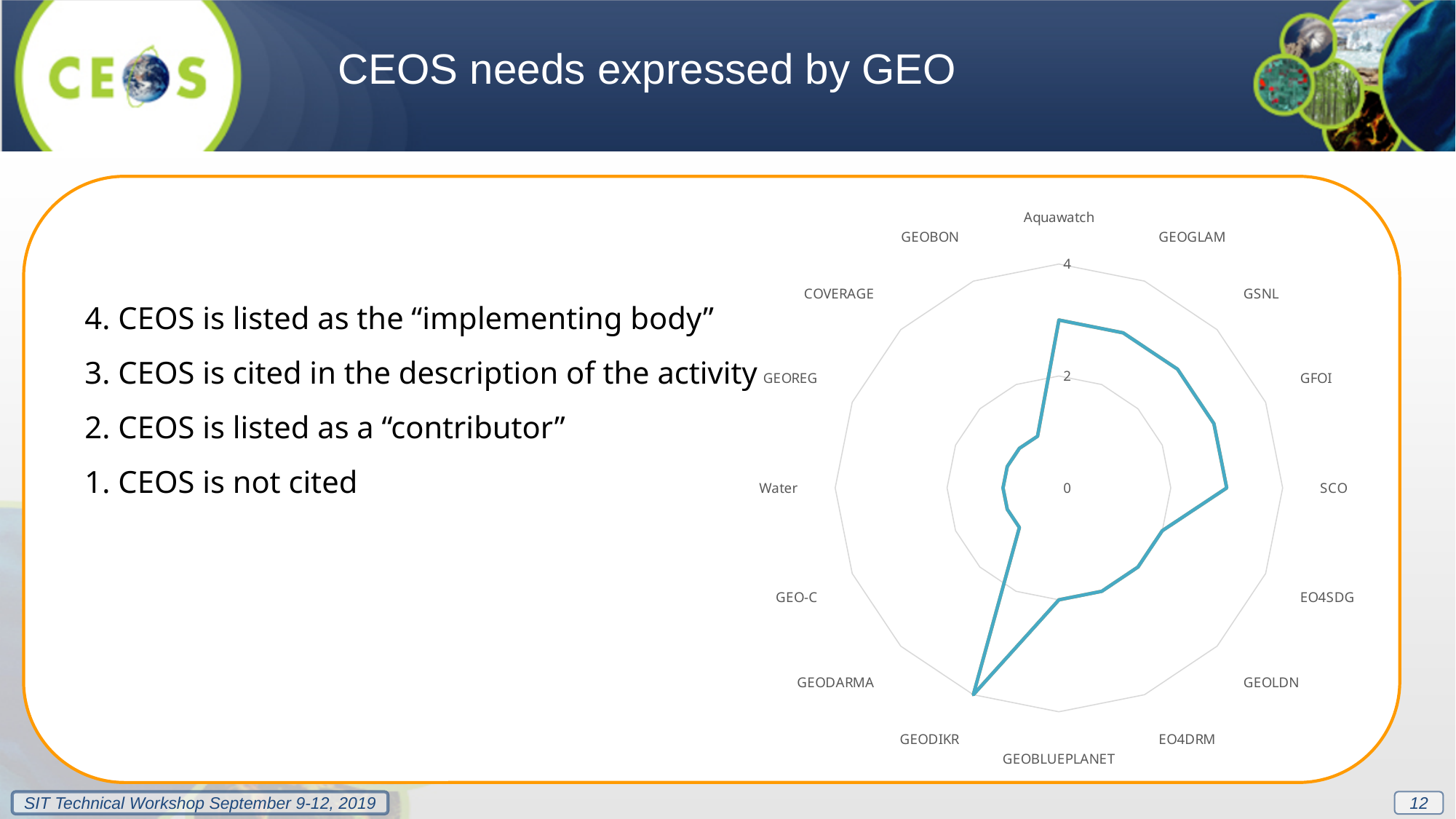
Is the value for Water greater or less than 2? less Is the value for SCO greater or less than 2? greater What is the maximum value shown on the radar chart's axis? 4 Which category has the highest value on the radar chart? GEODIKR Which has the larger value, SCO or Water? SCO Is the value for GEOREG greater or less than 2? less What is the value for GEODIKR on the radar chart? 4 Which has the larger value, GEODIKR or GEODARMA? GEODIKR How many categories are plotted around the radar chart? 16 What kind of chart is shown on the slide? Radar chart